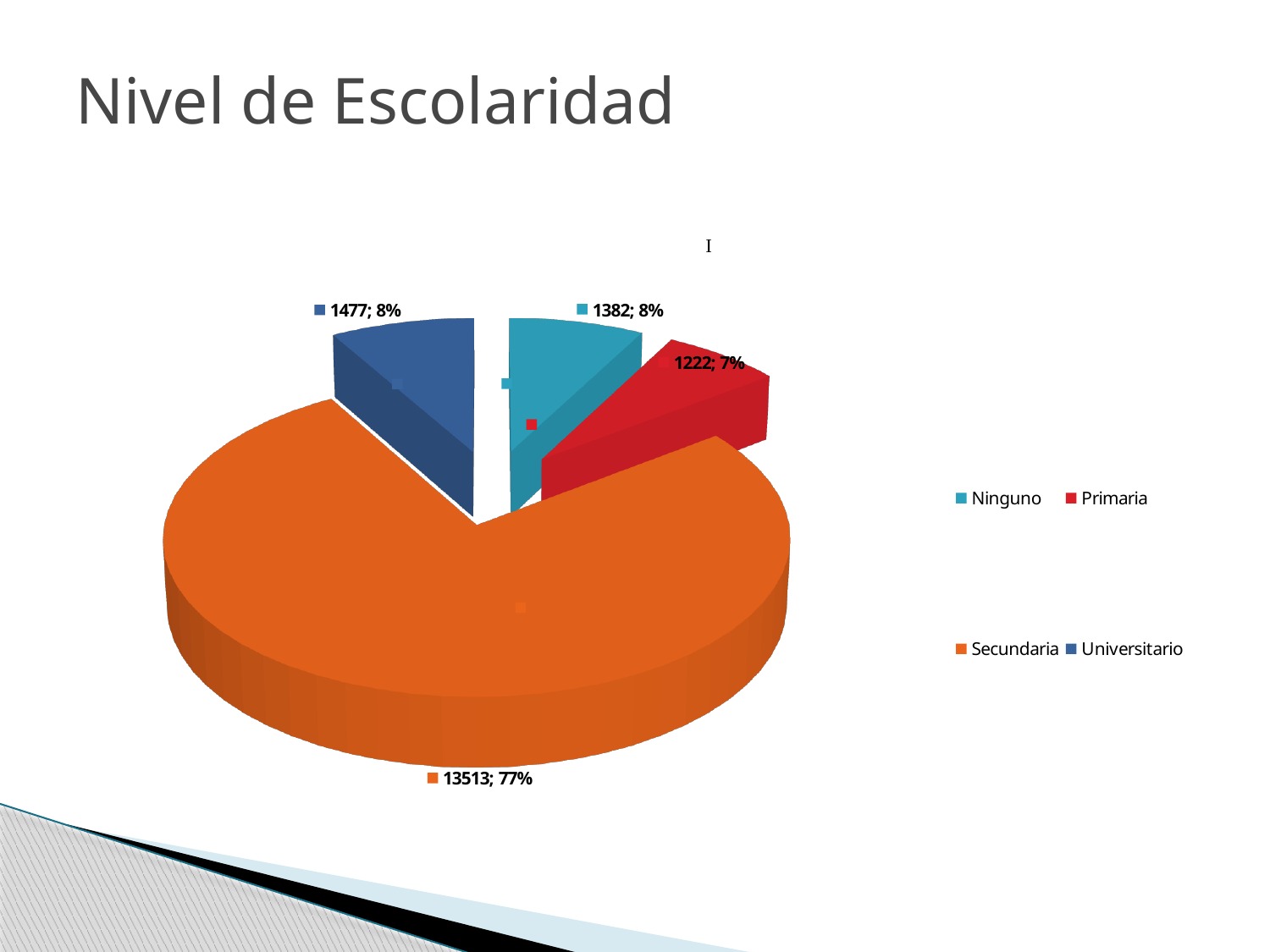
What is the value for Secundaria? 13513 What kind of chart is shown on the slide? pie chart What share of the pie does Primaria represent? 7% Which category has the smallest slice? Primaria How many categories does the legend list? 4 What is the difference between the values for Universitario and Ninguno? 95 What share of the pie does Secundaria represent? 77% What is the value for Ninguno? 1382 Which category has the largest slice? Secundaria What is the value for Universitario? 1477 What is the value for Primaria? 1222 Which is larger, the value for Universitario or the value for Ninguno? Universitario